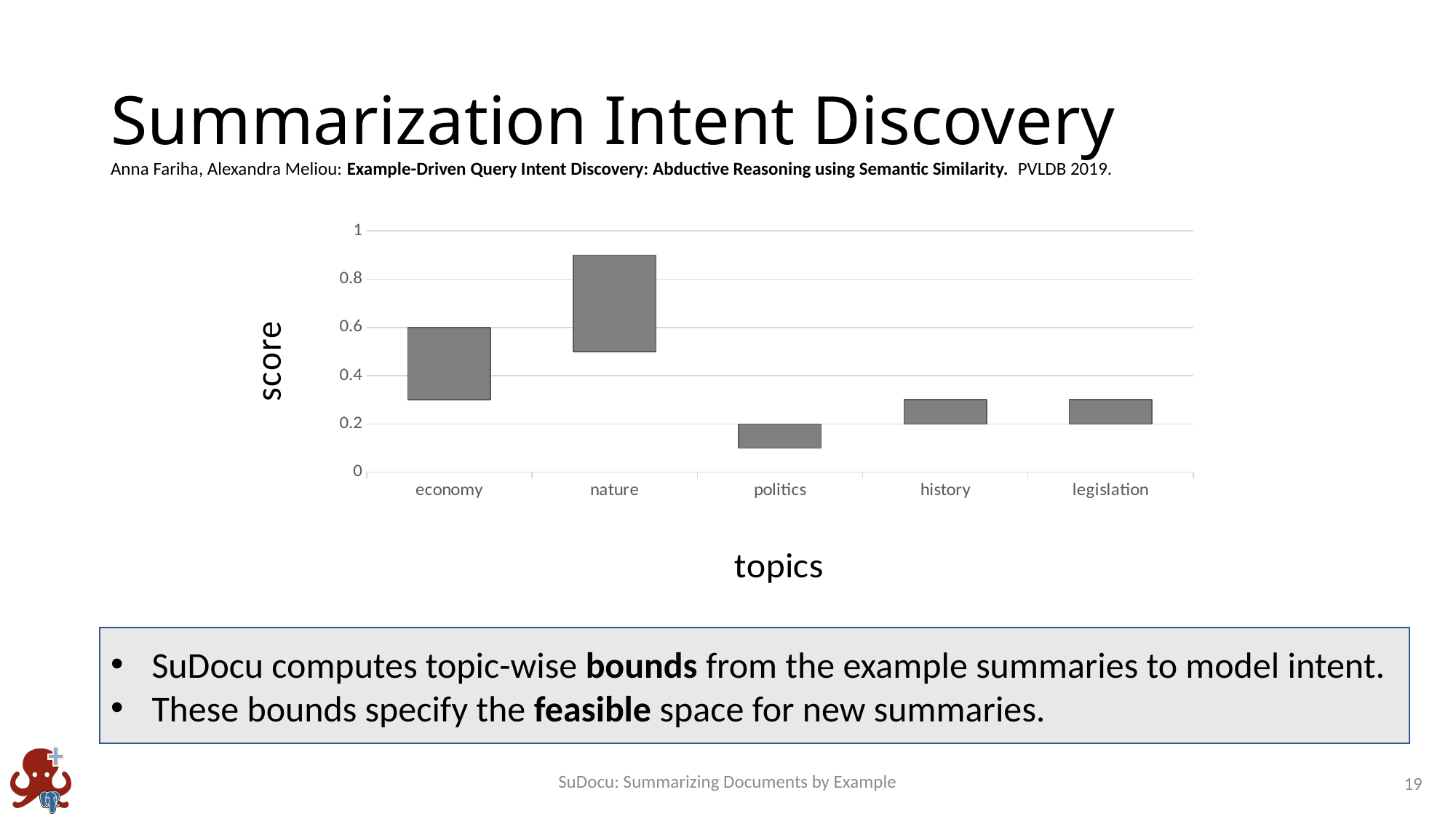
Is the lower bound of the bar for politics greater or less than 0.2? less What kind of chart is shown on the slide? bar chart What is the lower bound of the bar for history? 0.2 Is the lower bound of the bar for nature greater or less than 0.4? greater Which topic has the lowest bar in the chart? politics What is the label of the y axis of the chart? score How many topics are shown on the x axis of the chart? 5 Which topic has a higher upper bound, economy or politics? economy Is the upper bound of the bar for nature greater or less than 0.8? greater What is the upper bound of the bar for politics? 0.2 Which topic has the highest upper bound in the chart? nature What is the upper bound of the bar for economy? 0.6